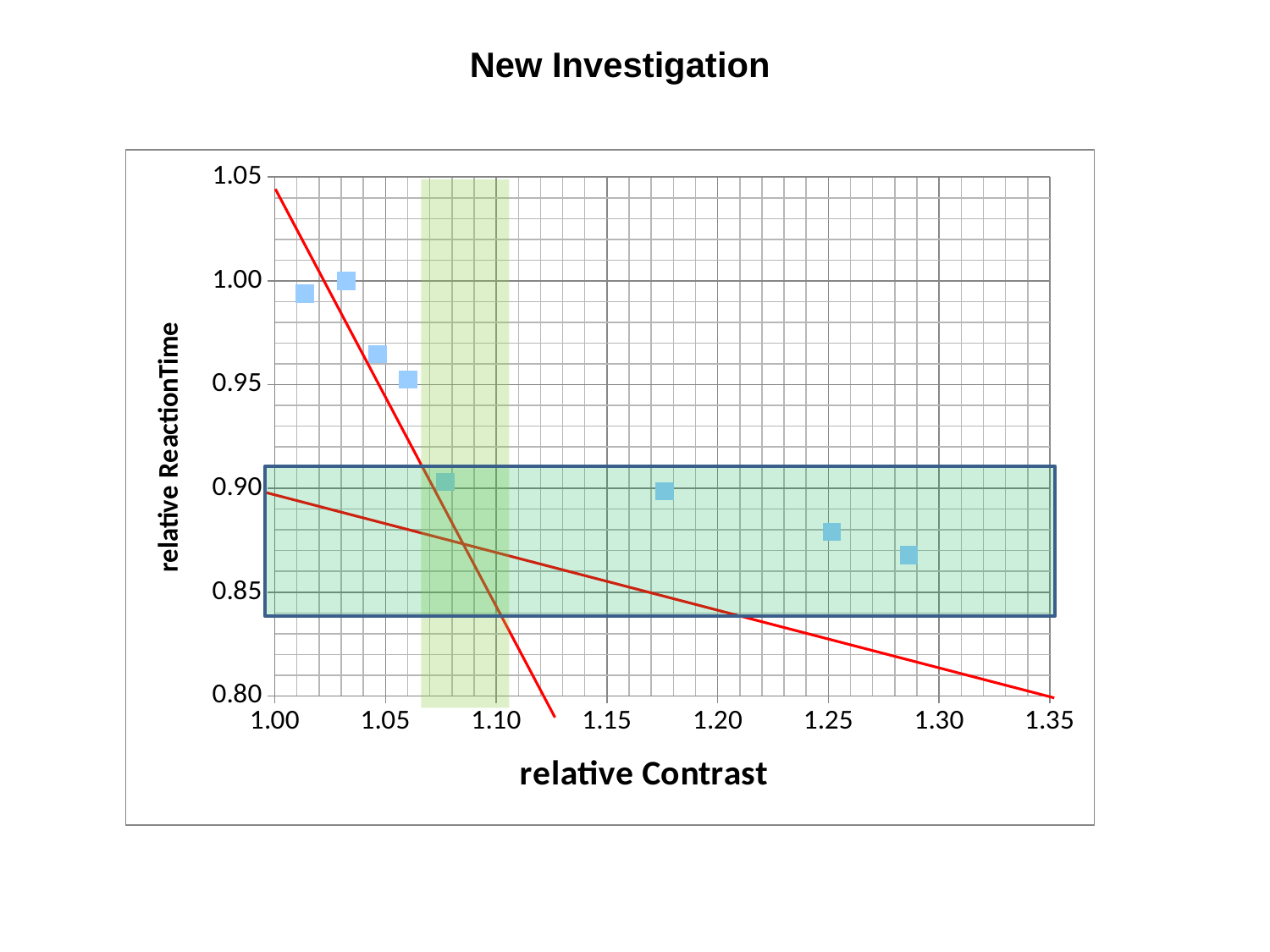
Which has the higher relative ReactionTime: the point at a relative Contrast of about 1.03 or the point at about 1.29? the point at about 1.03 What is the title of the chart? New Investigation Is the relative ReactionTime of the point at a relative Contrast of about 1.29 greater or less than 0.90? less Is the relative ReactionTime of the point at a relative Contrast of about 1.25 greater or less than 0.90? less Is the relative ReactionTime of the point at a relative Contrast of about 1.03 greater or less than 0.95? greater What kind of chart is shown on the slide? scatter chart How many data points are plotted in the chart? 8 As relative Contrast increases along the x axis, does relative ReactionTime generally rise or fall? fall What is the label of the x axis? relative Contrast What is the highest value shown on the x axis? 1.35